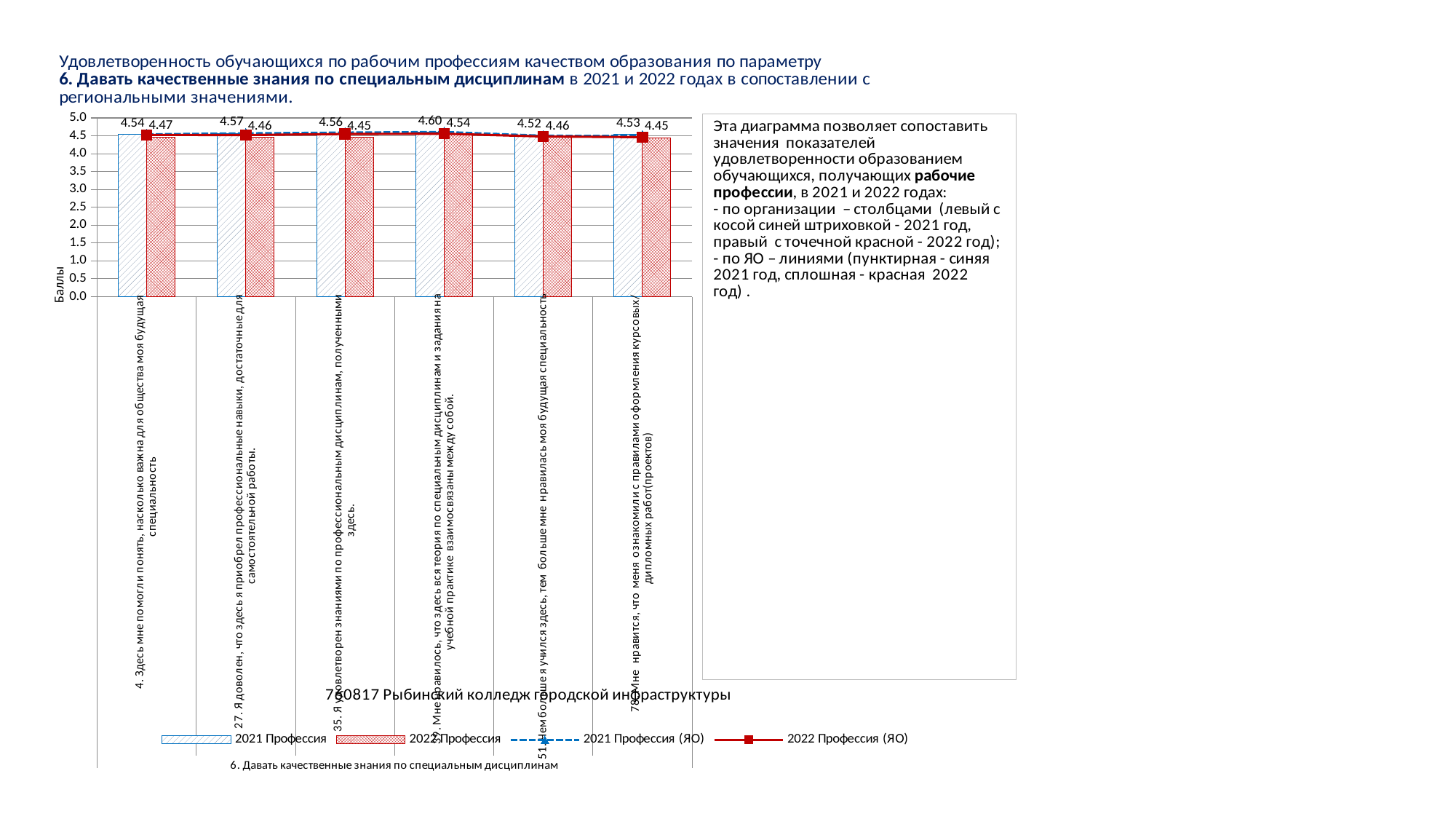
What is the left (first) value printed above the bars for the category '4. Здесь мне помогли понять, насколько важна для общества моя будущая специальность'? 4.54 What is the right (second) value printed above the bars for the category '35. Я удовлетворен знаниями по профессиональным дисциплинам, полученными здесь'? 4.45 What kind of chart is shown on the slide? A combined bar and line chart What is the label of the y axis of the chart? Баллы Is the value of the 2021 Профессия bar for the category '27. Я доволен, что здесь я приобрел профессиональные навыки...' greater or less than 4.0? greater How many categories (survey statements) are plotted along the x axis? 6 What is the right (second) value printed above the bars for the category '4. Здесь мне помогли понять, насколько важна для общества моя будущая специальность'? 4.47 Which category has the highest left (first) printed value? 39. Мне нравилось, что здесь вся теория по специальным дисциплинам и задания на учебной практике взаимосвязаны между собой (4.60) What is the left (first) value printed above the bars for the category '27. Я доволен, что здесь я приобрел профессиональные навыки, достаточные для самостоятельной работы'? 4.57 Which is larger for the category '35. Я удовлетворен знаниями по профессиональным дисциплинам, полученными здесь': the left printed value (4.56) or the right printed value (4.45)? The left value, 4.56 What is the difference between the two values printed for the category '4. Здесь мне помогли понять, насколько важна для общества моя будущая специальность' (4.54 and 4.47)? 0.07 How many series does the chart legend list? 4